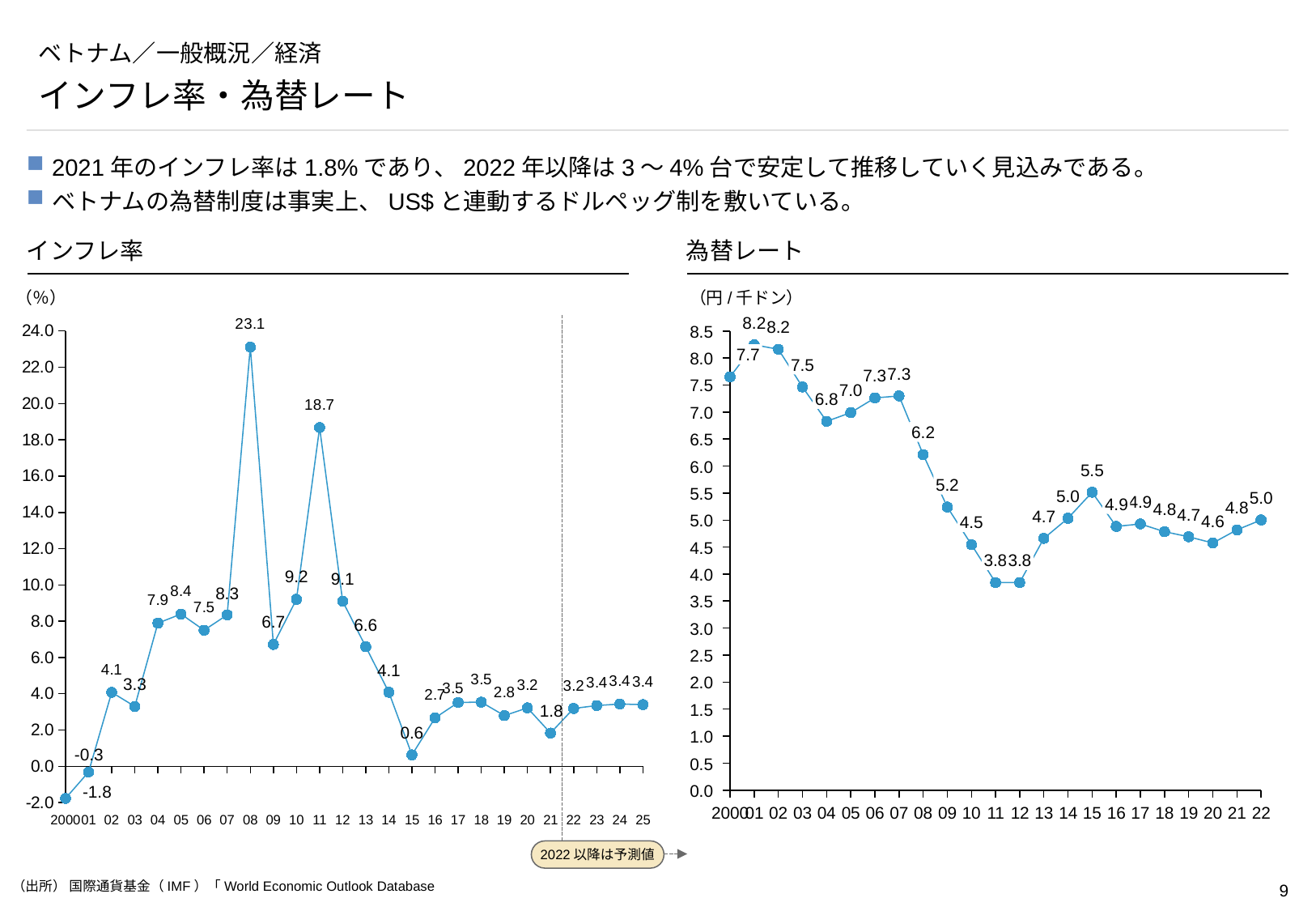
On the 為替レート chart, which year has the lowest value? 2011 (tied with 2012) On the インフレ率 chart, which year has the lowest inflation rate? 2000 On the 為替レート chart, is the value for 2008 larger than the value for 2009? Yes On the インフレ率 chart, what is the difference between the 2008 value and the 2011 value? 4.4 On the インフレ率 chart, what is the inflation rate for 2021? 1.8 On the 為替レート chart, what is the difference between the 2001 value and the 2022 value? 3.2 On the インフレ率 chart, is the value for 2015 greater or less than 2.0? less On the 為替レート chart, what is the value for 2015? 5.5 What kind of chart is the 為替レート chart? Line chart On the インフレ率 chart, which year has the highest inflation rate? 2008 On the 為替レート chart, do the values rise or fall from 2008 to 2011? Fall On the インフレ率 chart, what is the inflation rate for 2008? 23.1